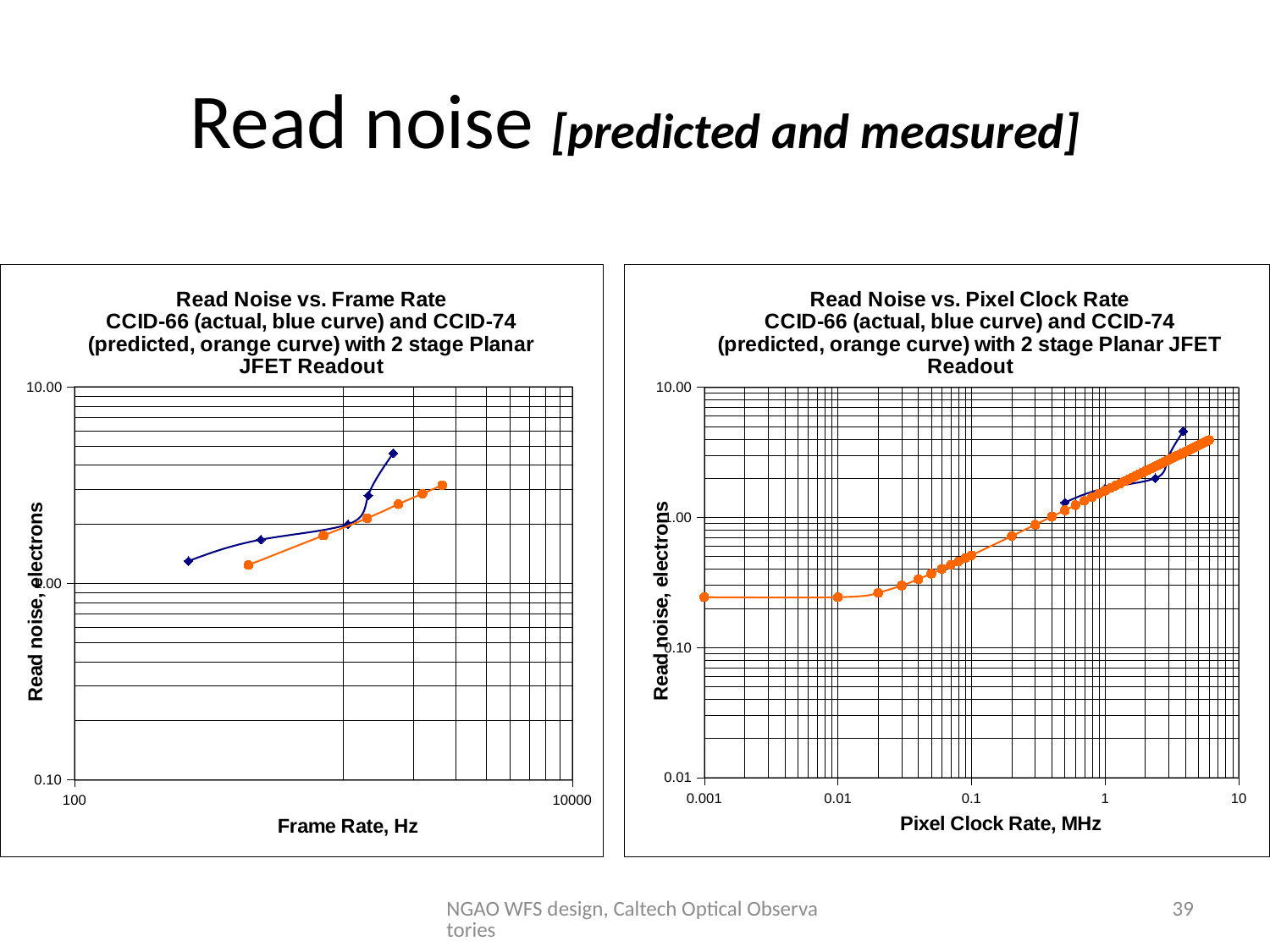
In the 'Read Noise vs. Pixel Clock Rate' chart on the right, is the read noise of the orange curve at 0.001 MHz greater or less than 1.00 electrons? less In the 'Read Noise vs. Frame Rate' chart on the left, how many data points are plotted on the blue curve? 5 In the 'Read Noise vs. Frame Rate' chart on the left, which device does the orange curve represent according to the chart title? CCID-74 (predicted) In the 'Read Noise vs. Pixel Clock Rate' chart on the right, does read noise rise or fall as pixel clock rate increases? rise In the 'Read Noise vs. Pixel Clock Rate' chart on the right, is the read noise of the orange curve at 0.001 MHz greater or less than 0.10 electrons? greater In the 'Read Noise vs. Frame Rate' chart on the left, how many data points are plotted on the orange curve? 6 What kind of chart is the 'Read Noise vs. Frame Rate' chart on the left? line chart In the 'Read Noise vs. Frame Rate' chart on the left, which curve reaches the higher maximum read noise, the blue curve or the orange curve? blue curve In the 'Read Noise vs. Frame Rate' chart on the left, does read noise rise or fall as frame rate increases? rise In the 'Read Noise vs. Frame Rate' chart on the left, is the highest read noise value on the blue curve greater or less than 1.00 electrons? greater What is the x-axis label of the 'Read Noise vs. Pixel Clock Rate' chart on the right? Pixel Clock Rate, MHz In the 'Read Noise vs. Pixel Clock Rate' chart on the right, how many data points are plotted on the blue curve? 5